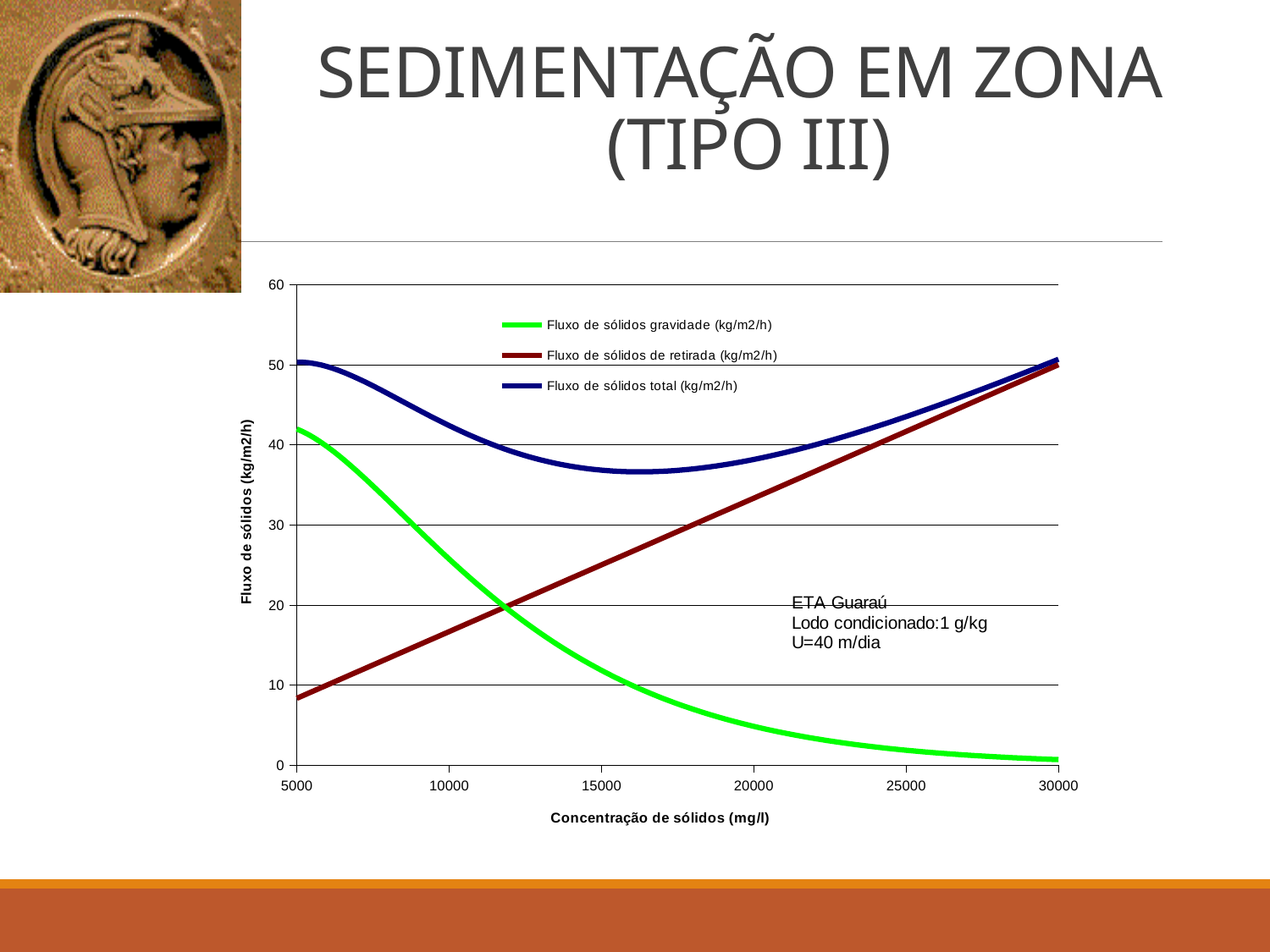
Is the value of 'Fluxo de sólidos total (kg/m2/h)' at 15000 mg/l greater or less than 40? less What is the title of the x axis? Concentração de sólidos (mg/l) At 25000 mg/l, which is larger: 'Fluxo de sólidos de retirada (kg/m2/h)' or 'Fluxo de sólidos gravidade (kg/m2/h)'? Fluxo de sólidos de retirada (kg/m2/h) What kind of chart is shown on the slide? line chart Is the value of 'Fluxo de sólidos gravidade (kg/m2/h)' at 30000 mg/l greater or less than 10? less Is the value of 'Fluxo de sólidos de retirada (kg/m2/h)' at 5000 mg/l greater or less than 10? less Does the 'Fluxo de sólidos de retirada (kg/m2/h)' line rise or fall as concentration increases from 5000 to 30000? rise How many series does the legend list? 3 What is the title of the y axis? Fluxo de sólidos (kg/m2/h) Does the 'Fluxo de sólidos gravidade (kg/m2/h)' line rise or fall as concentration increases from 5000 to 30000? fall Which series has the lowest value at 30000 mg/l? Fluxo de sólidos gravidade (kg/m2/h)